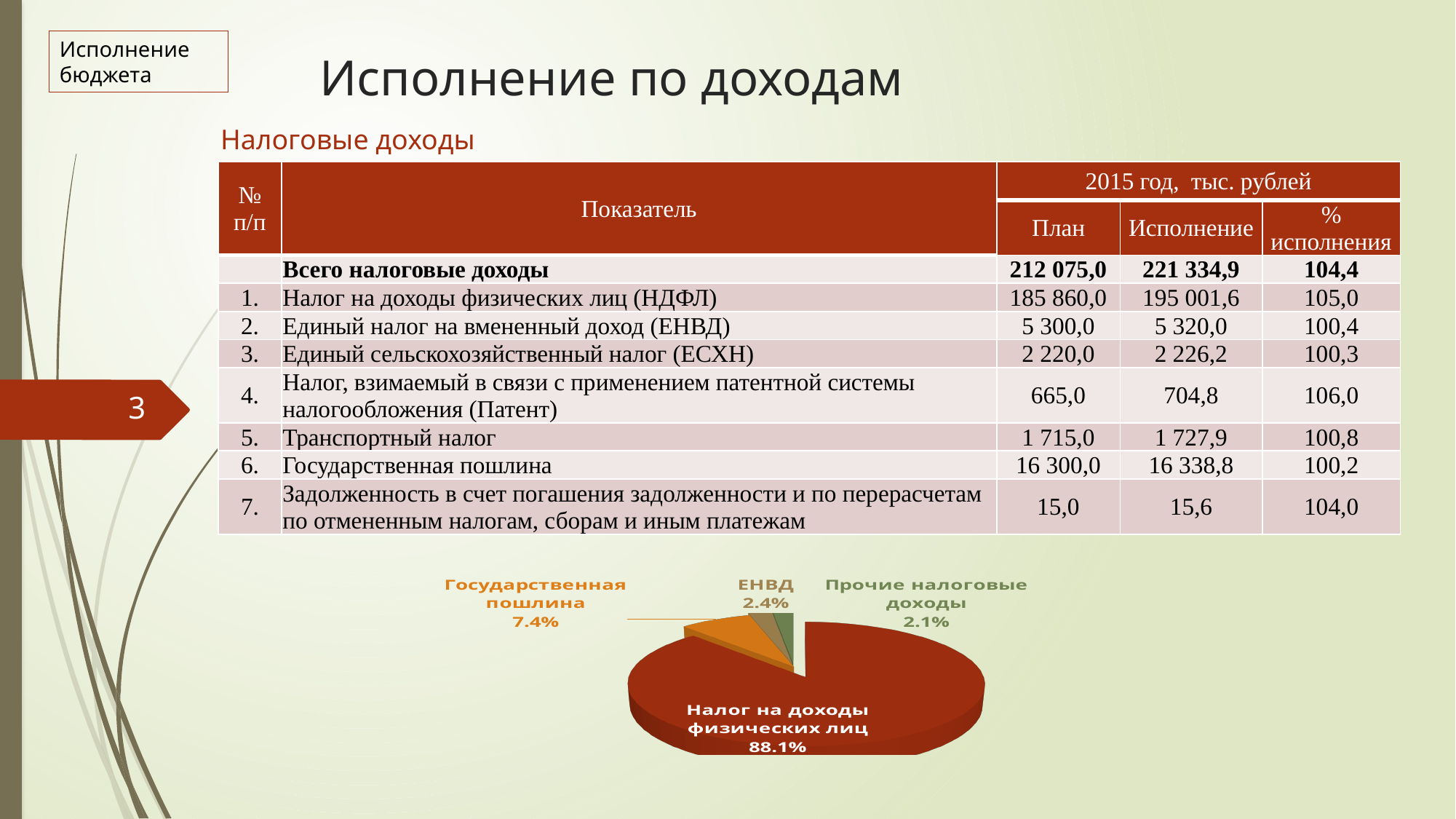
In the pie chart, what is the difference in percentage points between the "ЕНВД" share and the "Прочие налоговые доходы" share? 0.3 What kind of chart is shown at the bottom of the slide? pie chart What share of the pie chart is labelled "Государственная пошлина"? 7.4% What colour is the largest slice of the pie chart? dark red In the pie chart, which is larger: the share for "Государственная пошлина" or the share for "ЕНВД"? Государственная пошлина What share of the pie chart is labelled "ЕНВД"? 2.4% In the pie chart, what is the difference in percentage points between the "Государственная пошлина" share and the "ЕНВД" share? 5.0 What share of the pie chart is labelled "Налог на доходы физических лиц"? 88.1% Which slice of the pie chart is the largest? Налог на доходы физических лиц How many slices does the pie chart have? 4 Which slice of the pie chart is the smallest? Прочие налоговые доходы